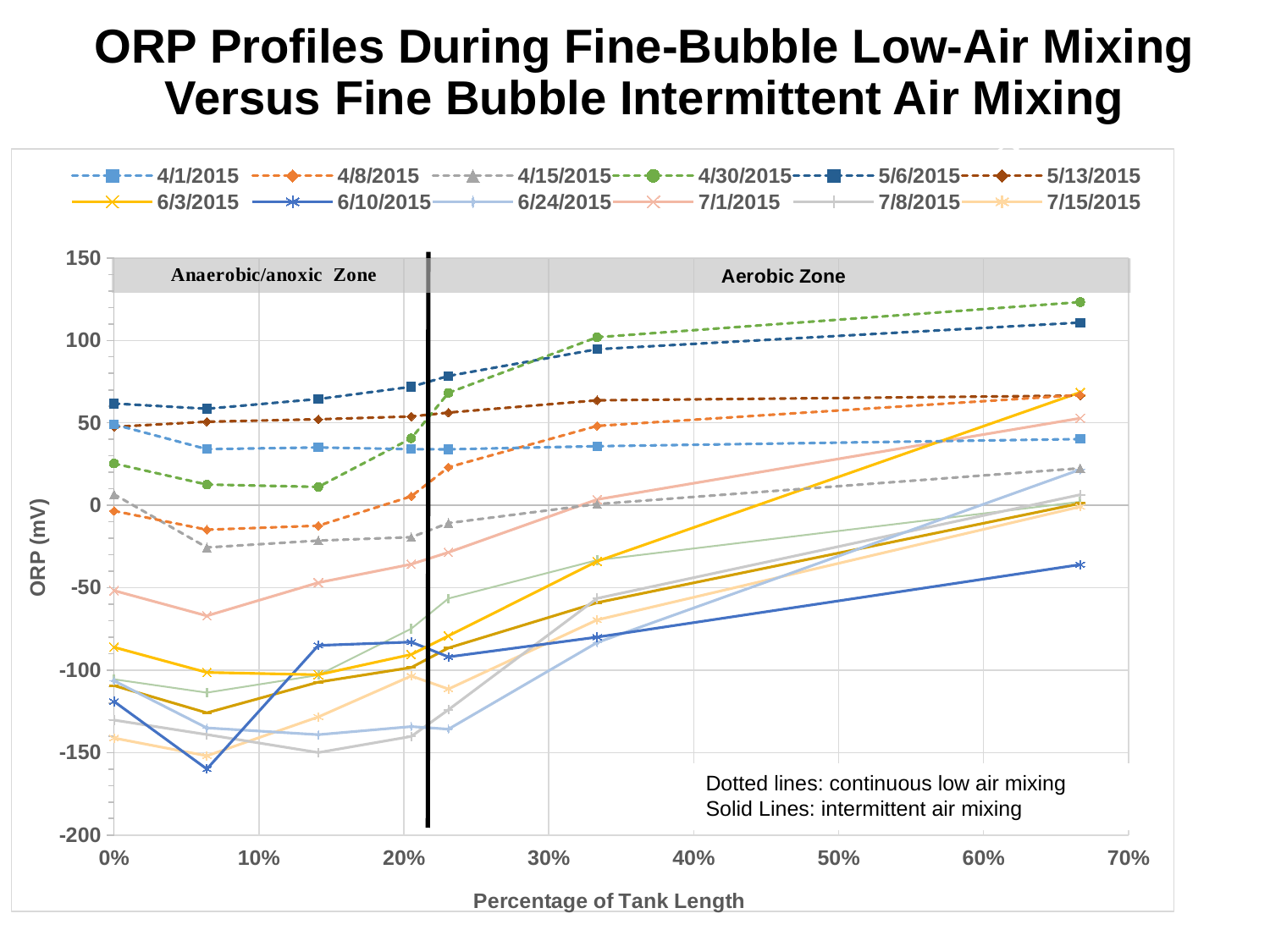
Which series has the lowest ORP value at about 67% of tank length? 6/10/2015 Which series has the highest ORP value at about 67% of tank length? 4/30/2015 Is the ORP value for 6/10/2015 at 0% of tank length greater or less than -100? less At 0% of tank length, which series has the higher ORP value, 5/6/2015 or 4/1/2015? 5/6/2015 Is the ORP value for 6/3/2015 at about 67% of tank length greater or less than 50? greater How many series does the legend list? 12 Does the ORP value for 6/10/2015 rise or fall between about 23% and 67% of tank length? rise According to the note on the chart, what do the dotted lines represent? Continuous low air mixing What kind of chart is shown on the slide? Line chart At about 67% of tank length, which series has the higher ORP value, 4/30/2015 or 5/6/2015? 4/30/2015 Is the ORP value for 4/30/2015 at about 67% of tank length greater or less than 100? greater